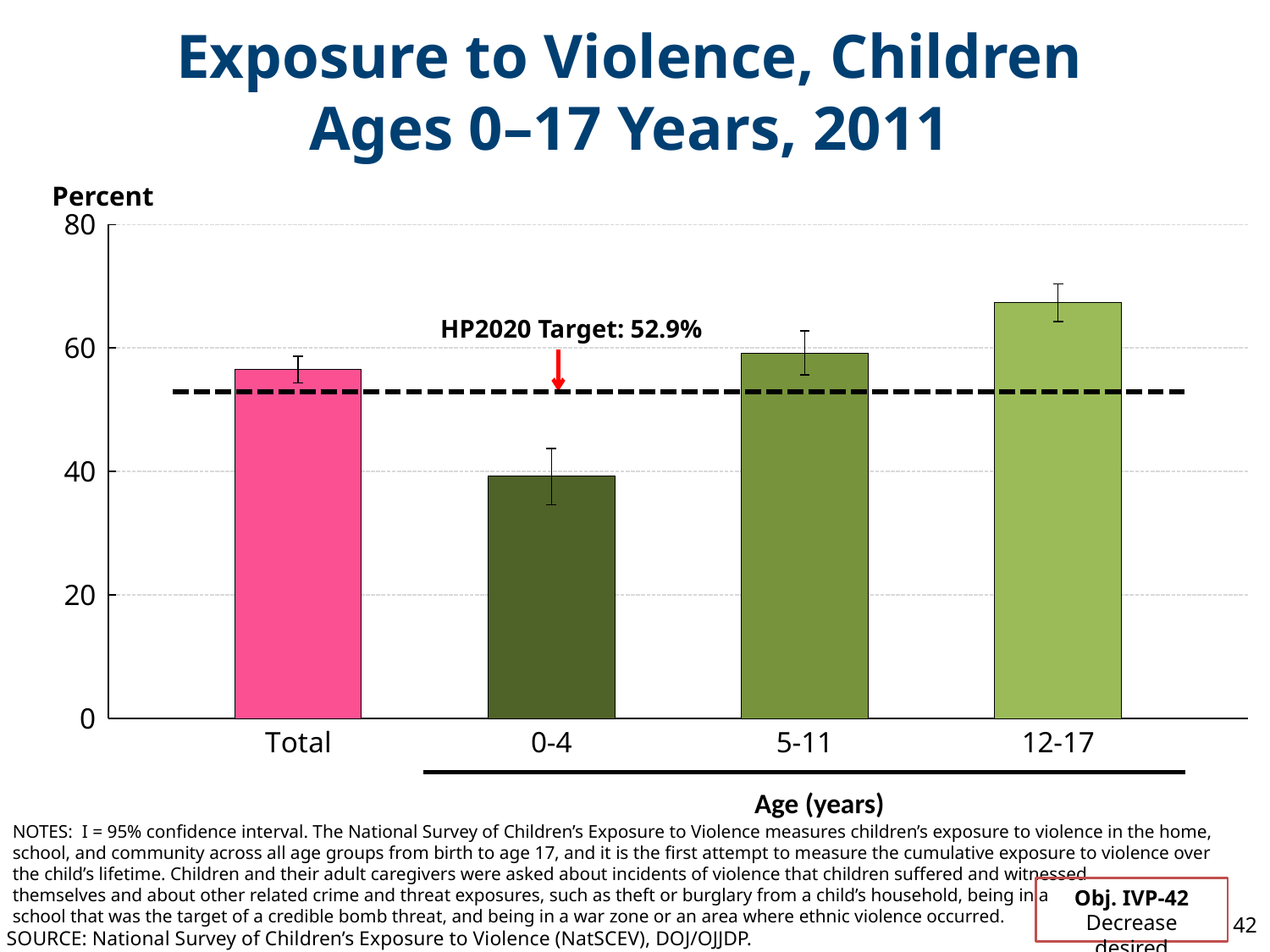
How many bars are plotted in the chart? 4 What kind of chart is shown on the slide? bar chart Which age group has the highest percentage of exposure to violence? 12-17 Is the value for the 5-11 age group greater or less than 40? greater Which age group has the lowest percentage of exposure to violence? 0-4 Do the values rise or fall across the age groups from 0-4 to 12-17? rise Is the value for the Total bar greater or less than 60? less Is the value for the 0-4 age group greater or less than 20? greater What is the label of the y axis? Percent What is the HP2020 Target value shown on the chart? 52.9% Which is larger, the value for the 5-11 age group or the 12-17 age group? 12-17